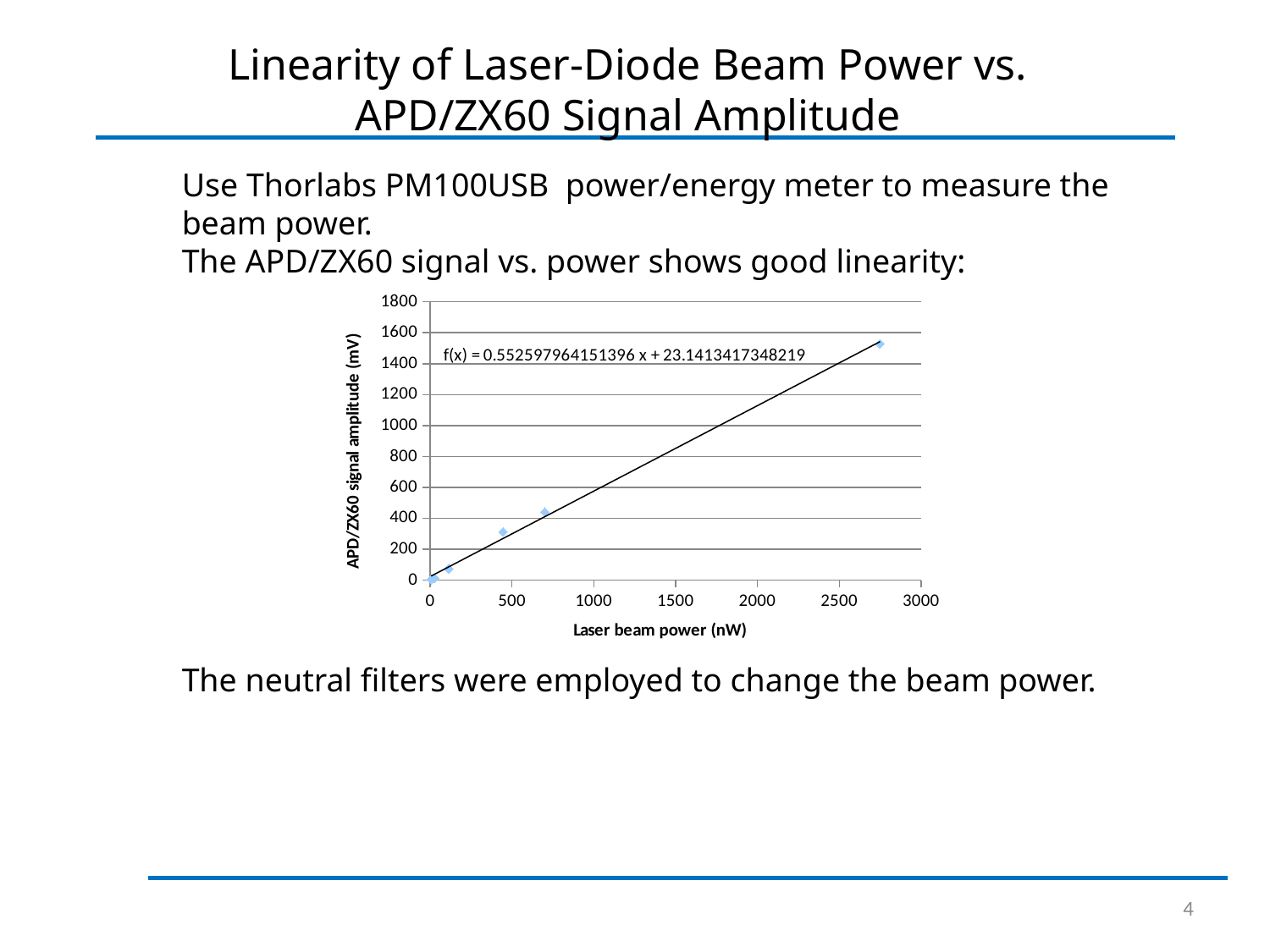
Does the APD/ZX60 signal amplitude rise or fall as laser beam power increases along the x axis? Rise What is the maximum value shown on the y axis of the chart? 1800 Is the signal amplitude of the point near 450 nW greater or less than 200 mV? greater What is the title of the y axis of the chart? APD/ZX60 signal amplitude (mV) What is the title of the x axis of the chart? Laser beam power (nW) Is the signal amplitude of the point near 700 nW greater or less than 600 mV? less What kind of chart is shown on the slide? Scatter chart What is the intercept of the fitted line shown in the equation on the chart? 23.1413417348219 What is the trendline equation printed on the chart? f(x) = 0.552597964151396 x + 23.1413417348219 Which has the larger signal amplitude: the point near 700 nW or the point near 450 nW? The point near 700 nW Is the signal amplitude of the highest plotted point (near 2750 nW) greater or less than 1400 mV? greater What is the slope of the fitted line shown in the equation on the chart? 0.552597964151396